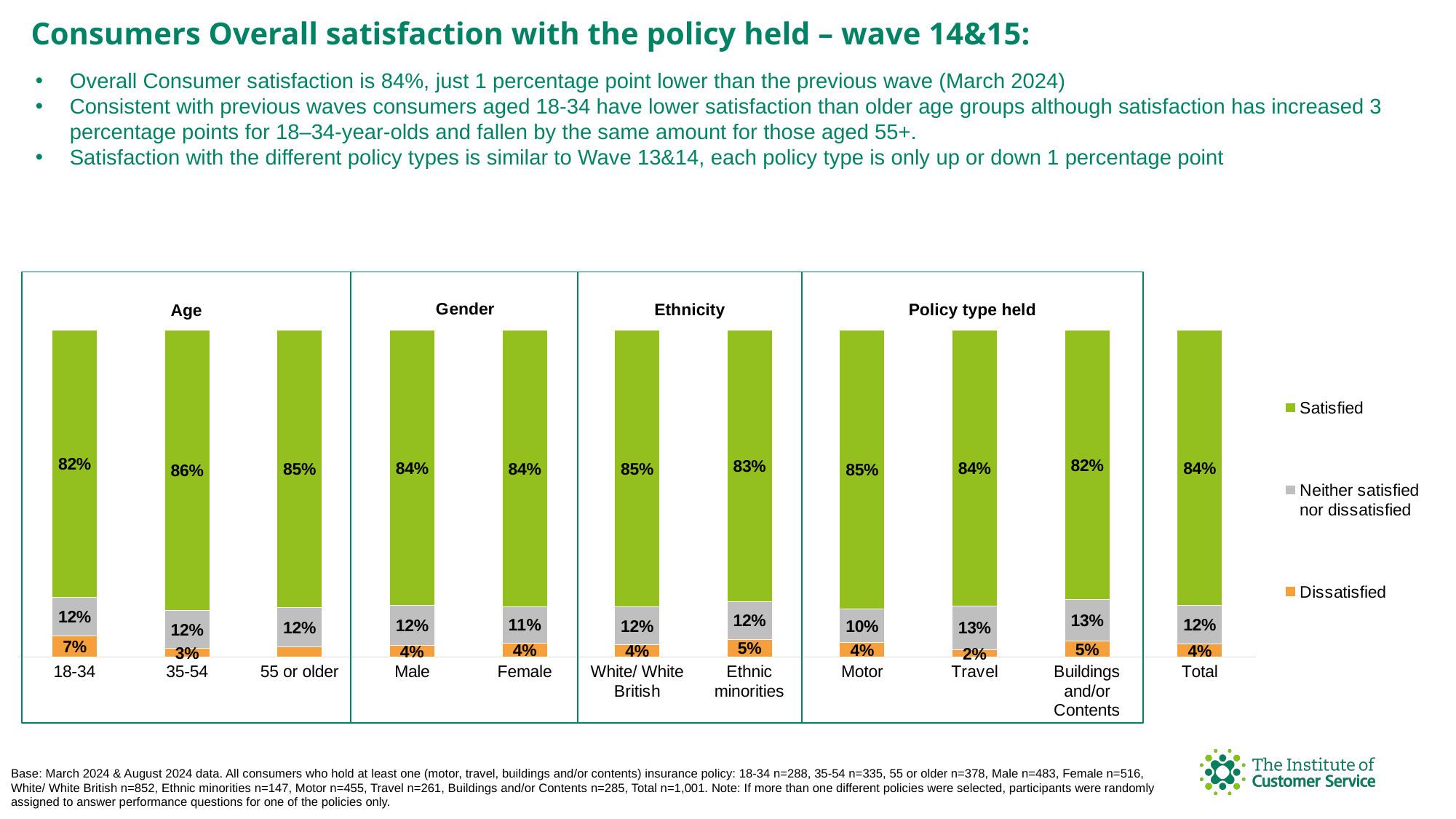
What is the Dissatisfied value for the 18-34 age group? 7% Which has a larger Neither satisfied nor dissatisfied value, Motor or Travel? Travel Which category has the lowest Dissatisfied percentage? Travel How many categories (bars) are shown in the chart? 11 What kind of chart is shown on the slide? Stacked bar chart Which category has the highest Dissatisfied percentage? 18-34 Which category has the highest Satisfied percentage? 35-54 How many percentage points higher is the Satisfied value for 35-54 than for 18-34? 4 percentage points What percentage of consumers aged 35-54 are Satisfied? 86% What is the Neither satisfied nor dissatisfied value for Travel? 13% How many series does the legend list? 3 What is the Satisfied value for the Total bar? 84%